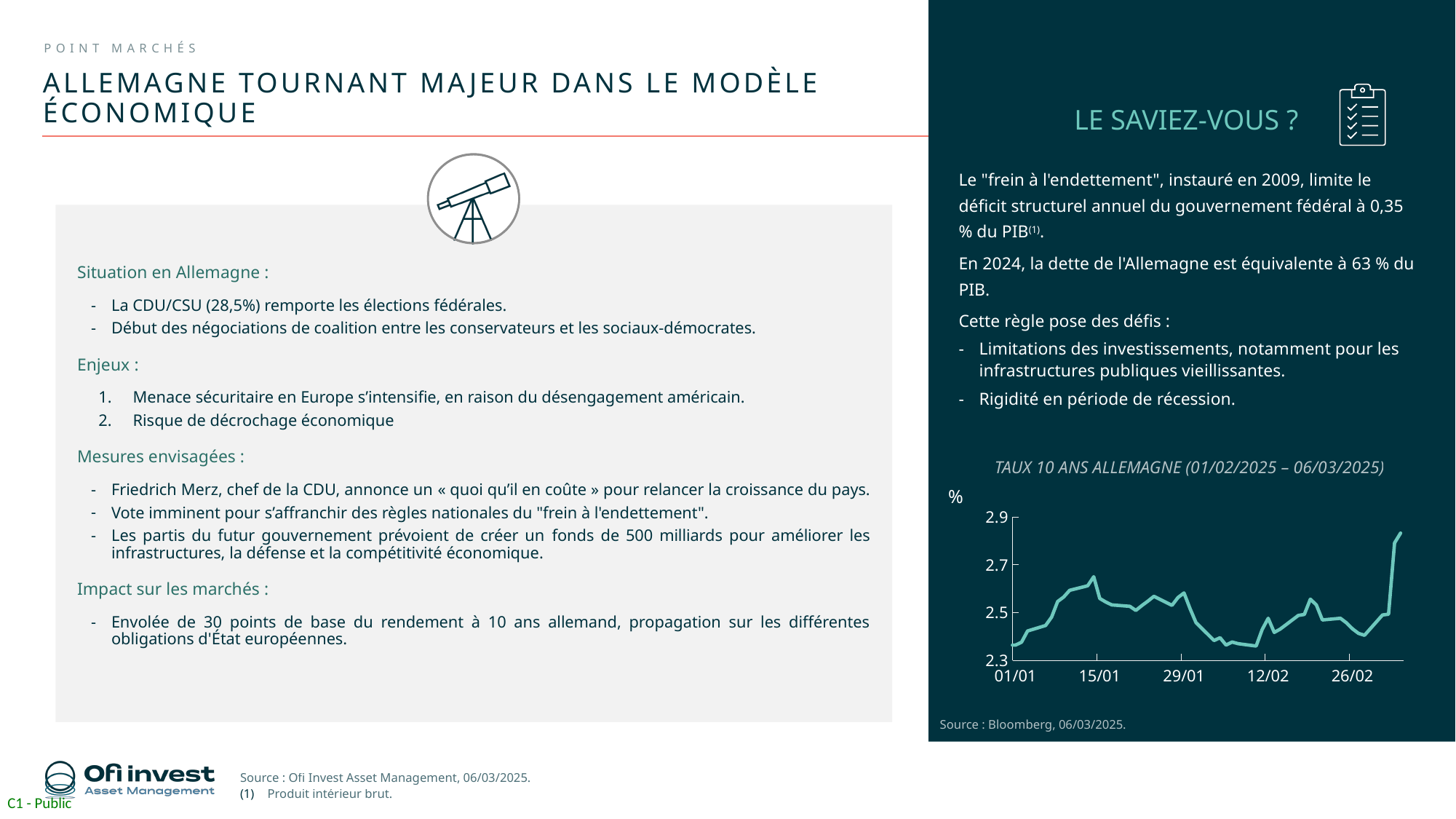
What kind of chart is shown under the title 'TAUX 10 ANS ALLEMAGNE'? line chart In the 'TAUX 10 ANS ALLEMAGNE' chart, is the value at 15/01 greater or less than 2.5? greater What is the title of the chart on the right-hand panel of the slide? TAUX 10 ANS ALLEMAGNE (01/02/2025 – 06/03/2025) In the 'TAUX 10 ANS ALLEMAGNE' chart, is the value at 26/02 greater or less than 2.7? less How many date labels are shown on the x axis of the 'TAUX 10 ANS ALLEMAGNE' chart? 5 In the 'TAUX 10 ANS ALLEMAGNE' chart, is the value at the end of the line higher or lower than at 01/01? higher In the 'TAUX 10 ANS ALLEMAGNE' chart, is the value at 01/01 greater or less than 2.5? less In the 'TAUX 10 ANS ALLEMAGNE' chart, where along the x axis does the line reach its highest value? at the end, after 26/02 What unit is shown on the y axis of the 'TAUX 10 ANS ALLEMAGNE' chart? % In the 'TAUX 10 ANS ALLEMAGNE' chart, does the line rise or fall sharply over the final days shown? rise